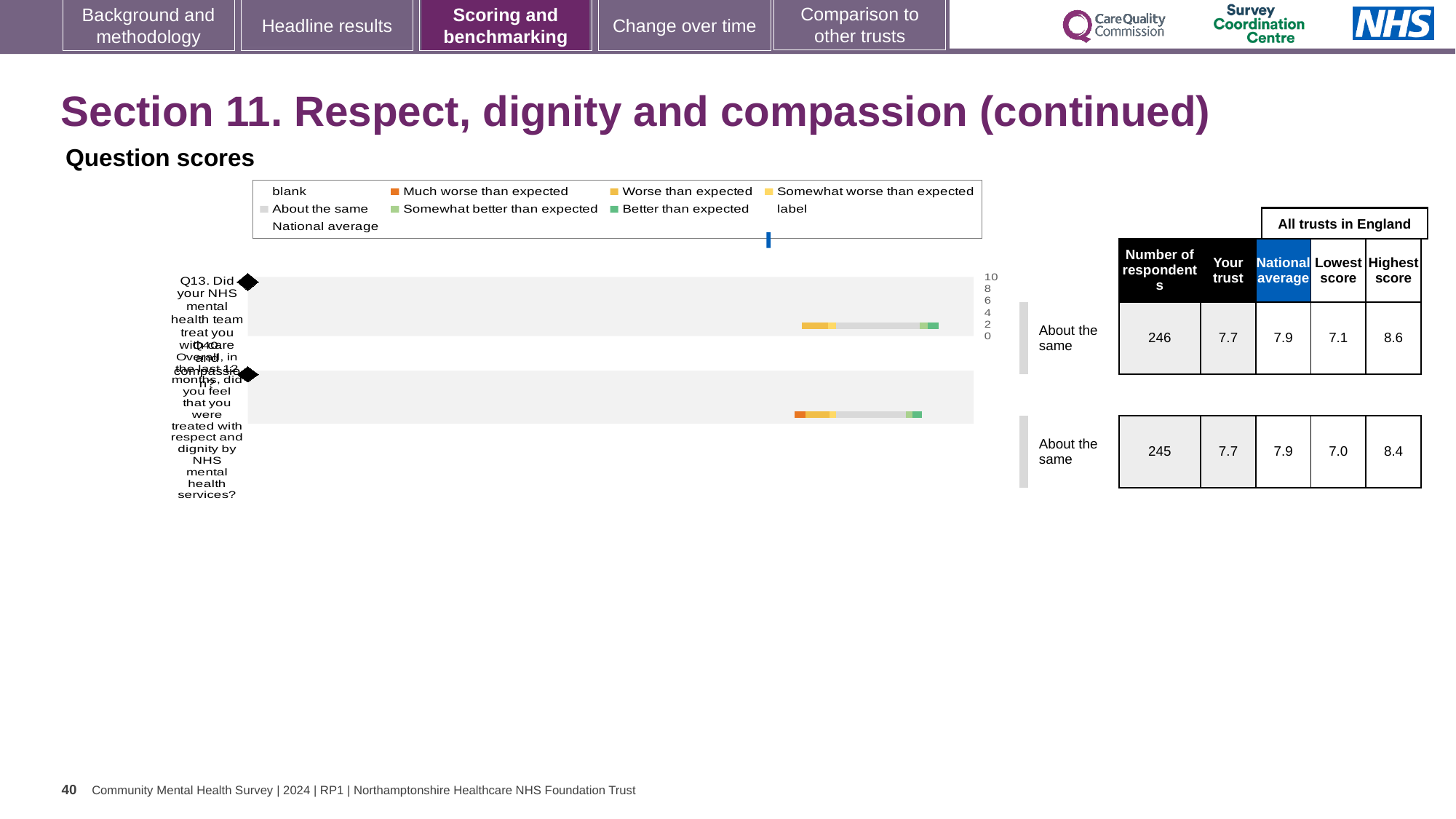
What is the difference between the highest score and the lowest score for Q13? 1.5 How many respondents are listed for Q13 in the table next to the chart? 246 For Q14, which is larger: the 'Your trust' score or the national average? National average What is the lowest score among all trusts in England for Q14? 7.0 What kind of chart is used to show the question scores on this slide? bar chart What is the national average score for Q13? 7.9 What benchmark category is shown for Q13? About the same Which question has the higher 'Highest score' value, Q13 or Q14? Q13 How many questions are plotted in the question scores chart? 2 How many more respondents answered Q13 than Q14? 1 What is the highest score among all trusts in England for Q13? 8.6 What is the 'Your trust' score for Q14? 7.7